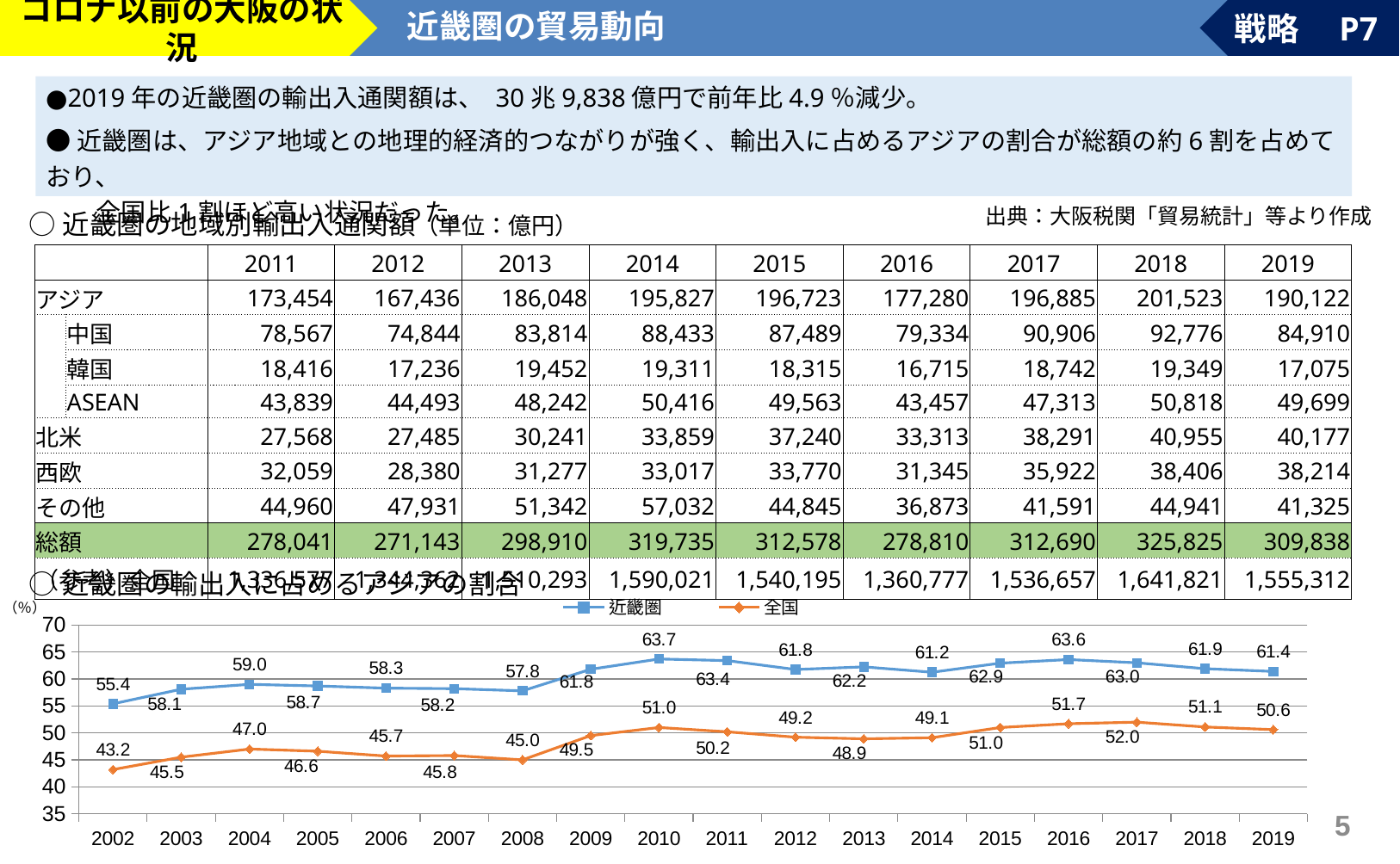
In the line chart 近畿圏の輸出入に占めるアジアの割合, which series has the higher value in 2010, 近畿圏 or 全国? 近畿圏 In the line chart 近畿圏の輸出入に占めるアジアの割合, how many years are plotted on the x axis? 18 In the line chart 近畿圏の輸出入に占めるアジアの割合, what is the difference between the 近畿圏 and 全国 values in 2019? 10.8 In the line chart 近畿圏の輸出入に占めるアジアの割合, what is the value for 近畿圏 in 2002? 55.4 In the line chart 近畿圏の輸出入に占めるアジアの割合, in which year is the 全国 value lowest? 2002 In the line chart 近畿圏の輸出入に占めるアジアの割合, how many series does the legend list? 2 In the line chart 近畿圏の輸出入に占めるアジアの割合, what is the value for 全国 in 2010? 51.0 What kind of chart is shown at the bottom of the slide (近畿圏の輸出入に占めるアジアの割合)? line chart In the line chart 近畿圏の輸出入に占めるアジアの割合, which series is drawn in orange? 全国 In the line chart 近畿圏の輸出入に占めるアジアの割合, is the 全国 value for 2008 greater or less than 50? less In the line chart 近畿圏の輸出入に占めるアジアの割合, what is the value for 近畿圏 in 2019? 61.4 In the line chart 近畿圏の輸出入に占めるアジアの割合, in which year is the 全国 value highest? 2017